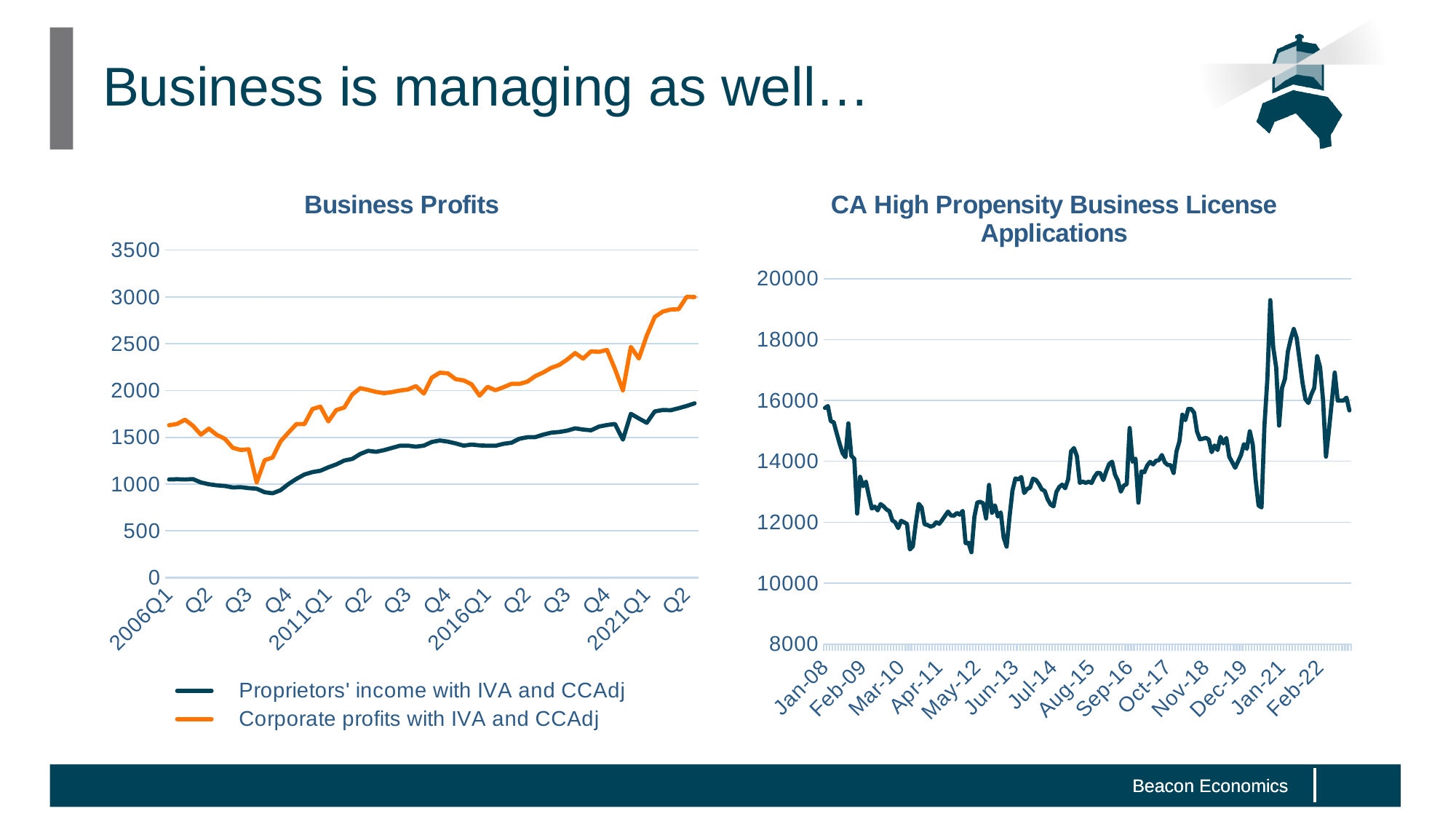
What kind of chart is the "Business Profits" chart? line chart In the "Business Profits" chart, is the value of Proprietors' income with IVA and CCAdj at 2021Q2 greater or less than 2000? less How many series does the legend of the "Business Profits" chart list? 2 In the "CA High Propensity Business License Applications" chart, do the values rise or fall between Jan-08 and Mar-10? fall In the "Business Profits" chart, is the value of Corporate profits with IVA and CCAdj at 2006Q1 greater or less than 1500? greater In the "CA High Propensity Business License Applications" chart, is the value at Jan-08 greater or less than 14000? greater In the "Business Profits" chart, does Proprietors' income with IVA and CCAdj generally rise or fall from 2011Q1 to 2021Q2? rise What is the title of the chart on the right side of the slide? CA High Propensity Business License Applications In the "Business Profits" chart, which series has the higher value at 2016Q1, Corporate profits with IVA and CCAdj or Proprietors' income with IVA and CCAdj? Corporate profits with IVA and CCAdj In the "Business Profits" chart, which series is drawn in orange? Corporate profits with IVA and CCAdj